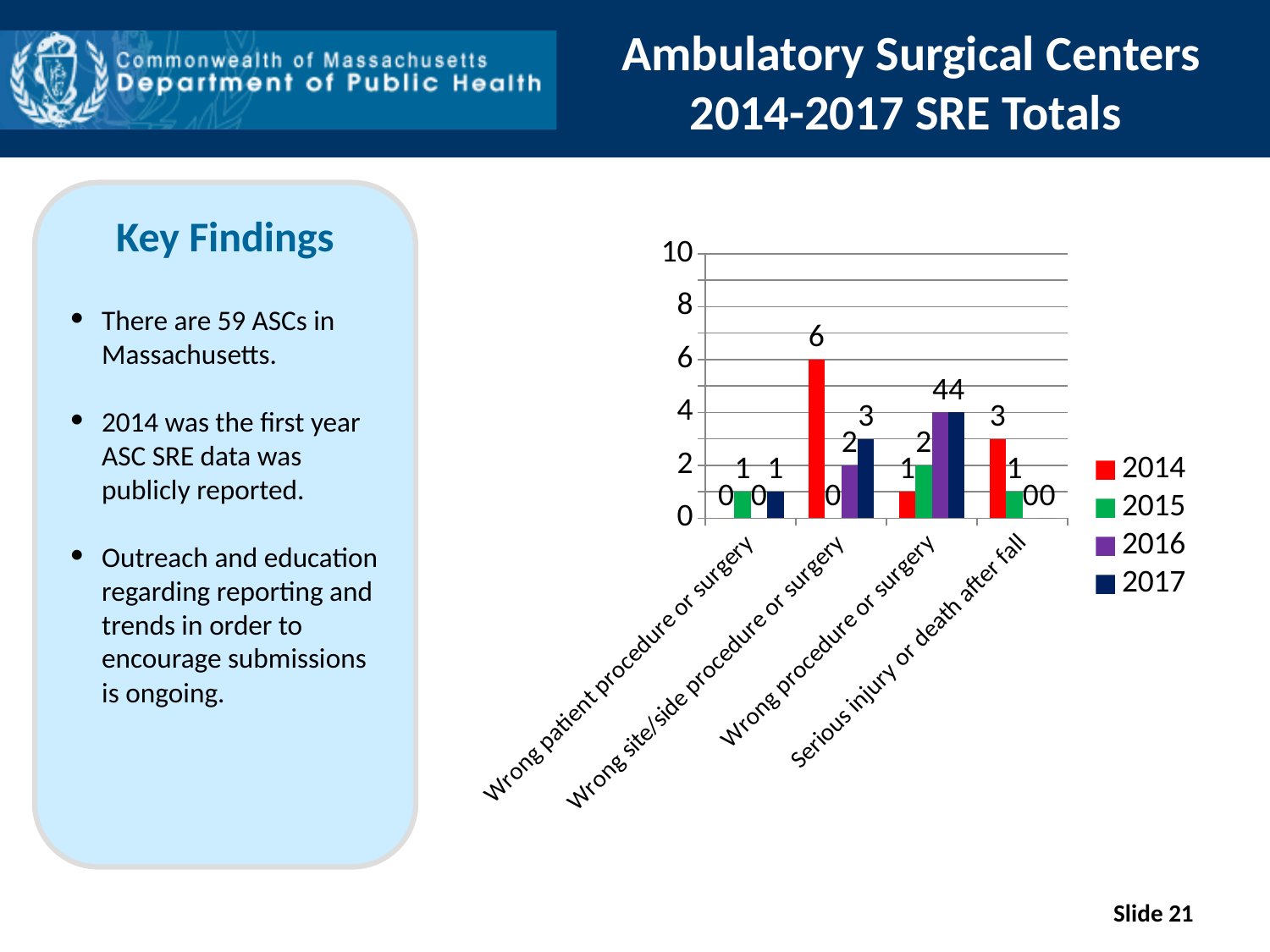
What is the 2016 value for Wrong procedure or surgery? 4 How many series does the chart legend list? 4 Which colour represents the 2014 series in the chart legend? Red What is the 2014 value for Serious injury or death after fall? 3 What is the difference between the 2014 and 2017 values for Wrong site/side procedure or surgery? 3 What is the 2017 value for Wrong site/side procedure or surgery? 3 Which category has the lowest 2017 value? Serious injury or death after fall Which category has the highest 2014 value? Wrong site/side procedure or surgery What is the 2014 value for Wrong site/side procedure or surgery? 6 How many categories are shown on the x axis of the chart? 4 Which is larger for Wrong procedure or surgery: the 2015 value or the 2016 value? 2016 What type of chart is shown on the slide? Bar chart